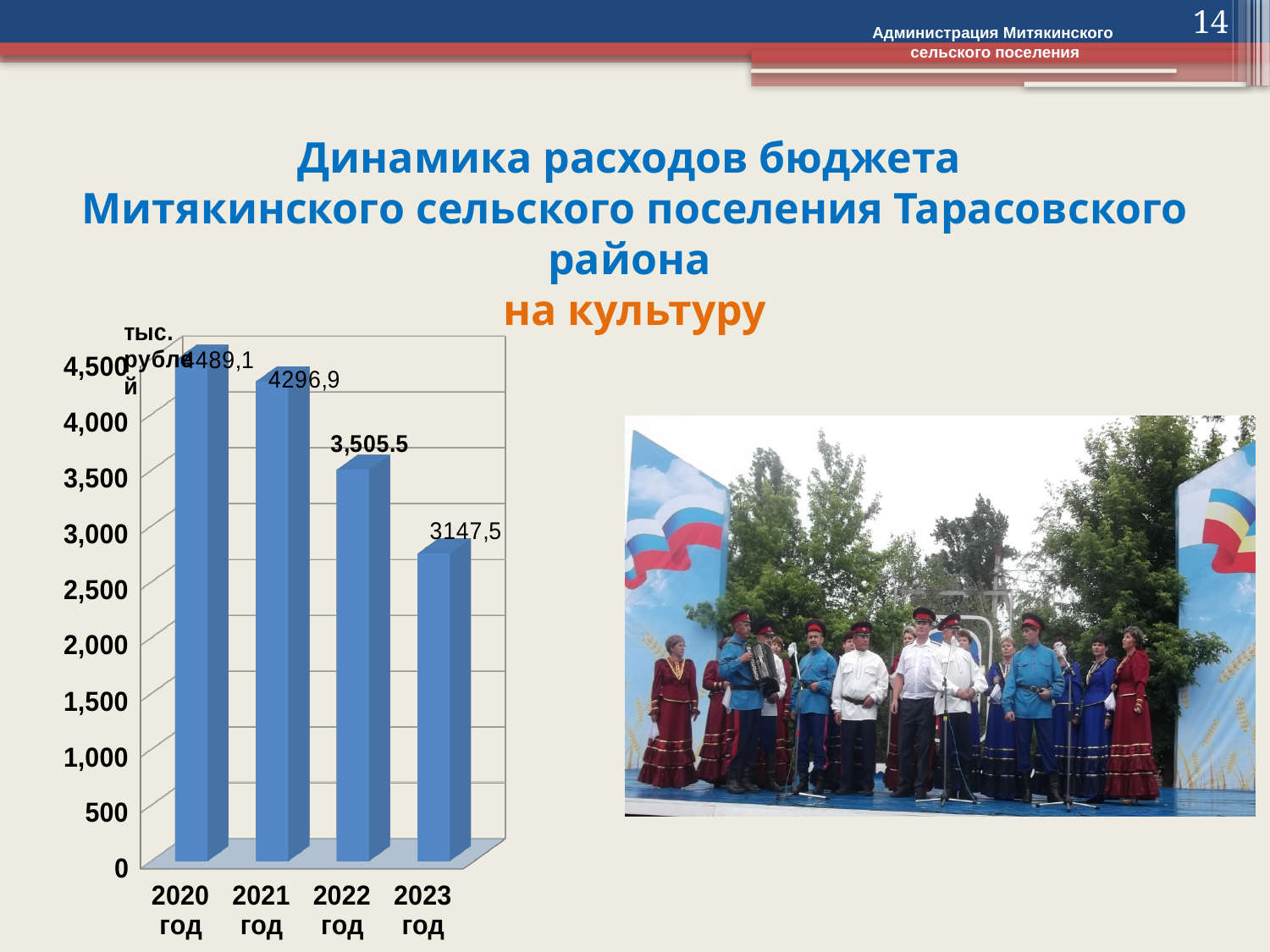
Which year has the highest value in the chart? 2020 год How many years (categories) are plotted in the chart? 4 What is the value shown for 2022 год? 3,505.5 Do the values rise or fall from 2020 год to 2023 год? fall Is the value for 2023 год greater or less than 3,500? less What type of chart is shown on the slide? bar chart What is the value shown for 2021 год? 4296,9 Which year has the lowest value in the chart? 2023 год What is the value shown for 2020 год? 4489,1 What is the difference between the values for 2020 год and 2021 год? 192,2 What is the value shown for 2023 год? 3147,5 Which is larger, the value for 2021 год or the value for 2022 год? 2021 год